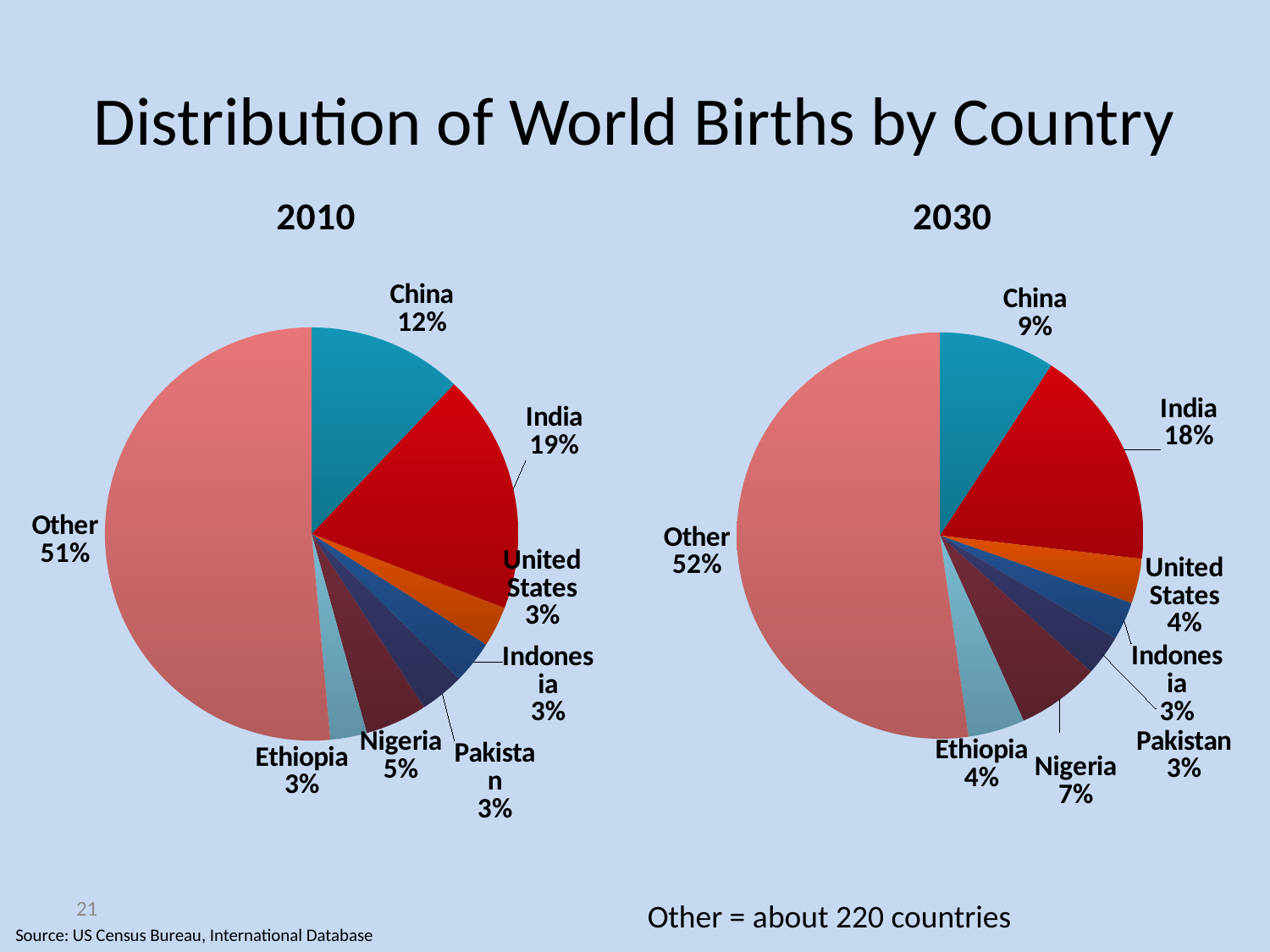
In the 2010 pie chart, what share of world births is attributed to India? 19% In the 2030 pie chart, what is the share for Other? 52% In the 2030 pie chart, is the share for Nigeria larger or smaller than the share for China? smaller In the 2030 pie chart, what is the difference between India's share and Nigeria's share? 11% How many slices does the 2010 pie chart have? 8 In the 2030 pie chart, what share of world births is attributed to Nigeria? 7% What is the difference between China's share in the 2010 chart and China's share in the 2030 chart? 3% In the 2010 pie chart, which named country (excluding Other) has the largest share? India What type of chart is used on this slide? pie chart In the 2010 pie chart, is the share for China larger or smaller than the share for Nigeria? larger In the 2010 pie chart, what is the share for China? 12% In the 2030 pie chart, which slice is the largest overall? Other